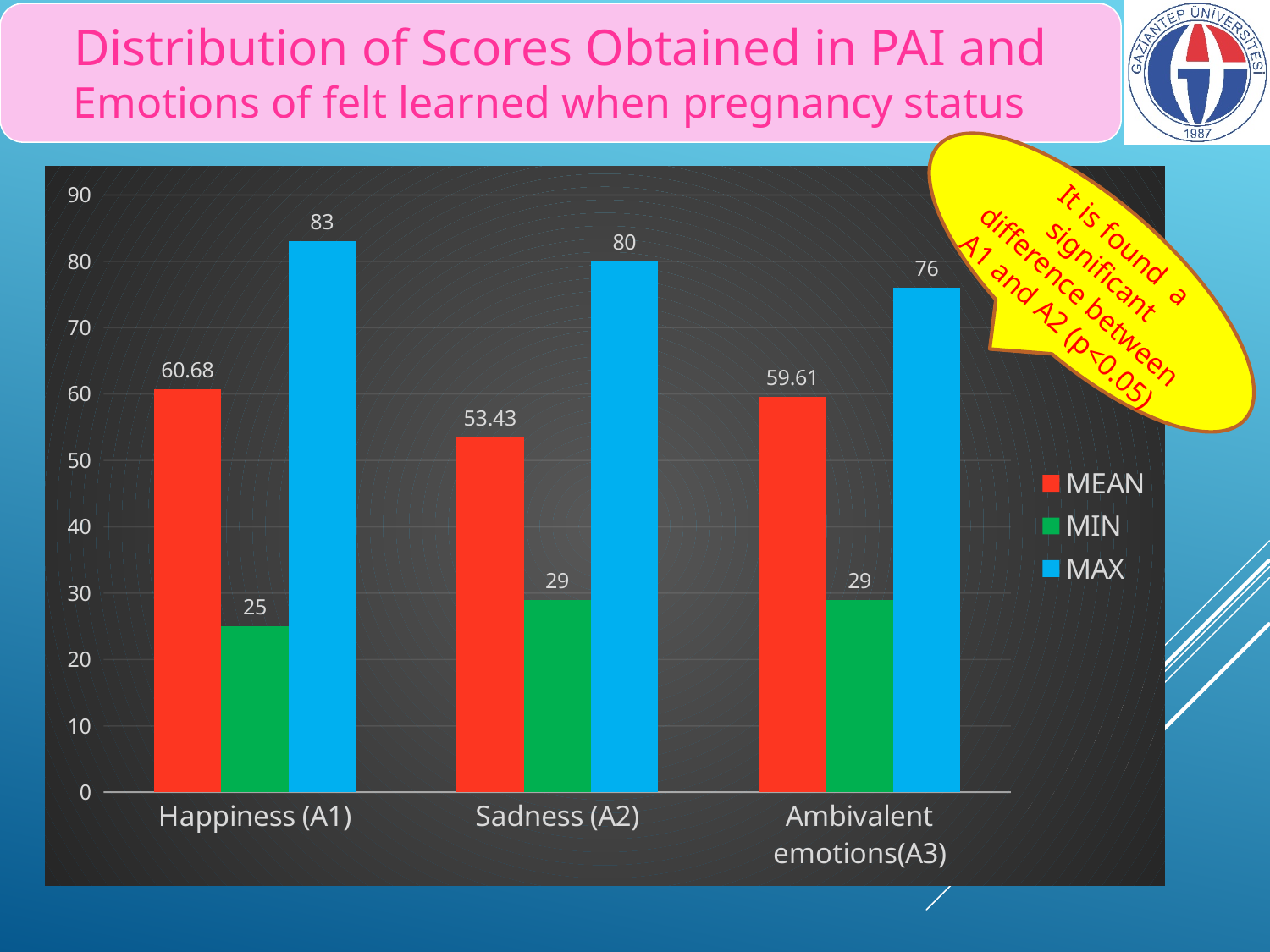
Which category has the lowest MIN value? Happiness (A1) Which is larger, the MEAN for Sadness (A2) or the MEAN for Ambivalent emotions(A3)? Ambivalent emotions(A3) Which category has the highest MEAN value? Happiness (A1) What is the MAX value for Sadness (A2)? 80 Is the MAX value for Sadness (A2) greater or less than 70? greater What kind of chart is shown on the slide? bar chart What is the MEAN value for Happiness (A1)? 60.68 How many series does the legend list? 3 What is the MIN value for Ambivalent emotions(A3)? 29 How many categories are shown on the x axis? 3 What colour represents the MAX series in the legend? blue What is the difference between the MAX values for Happiness (A1) and Ambivalent emotions(A3)? 7